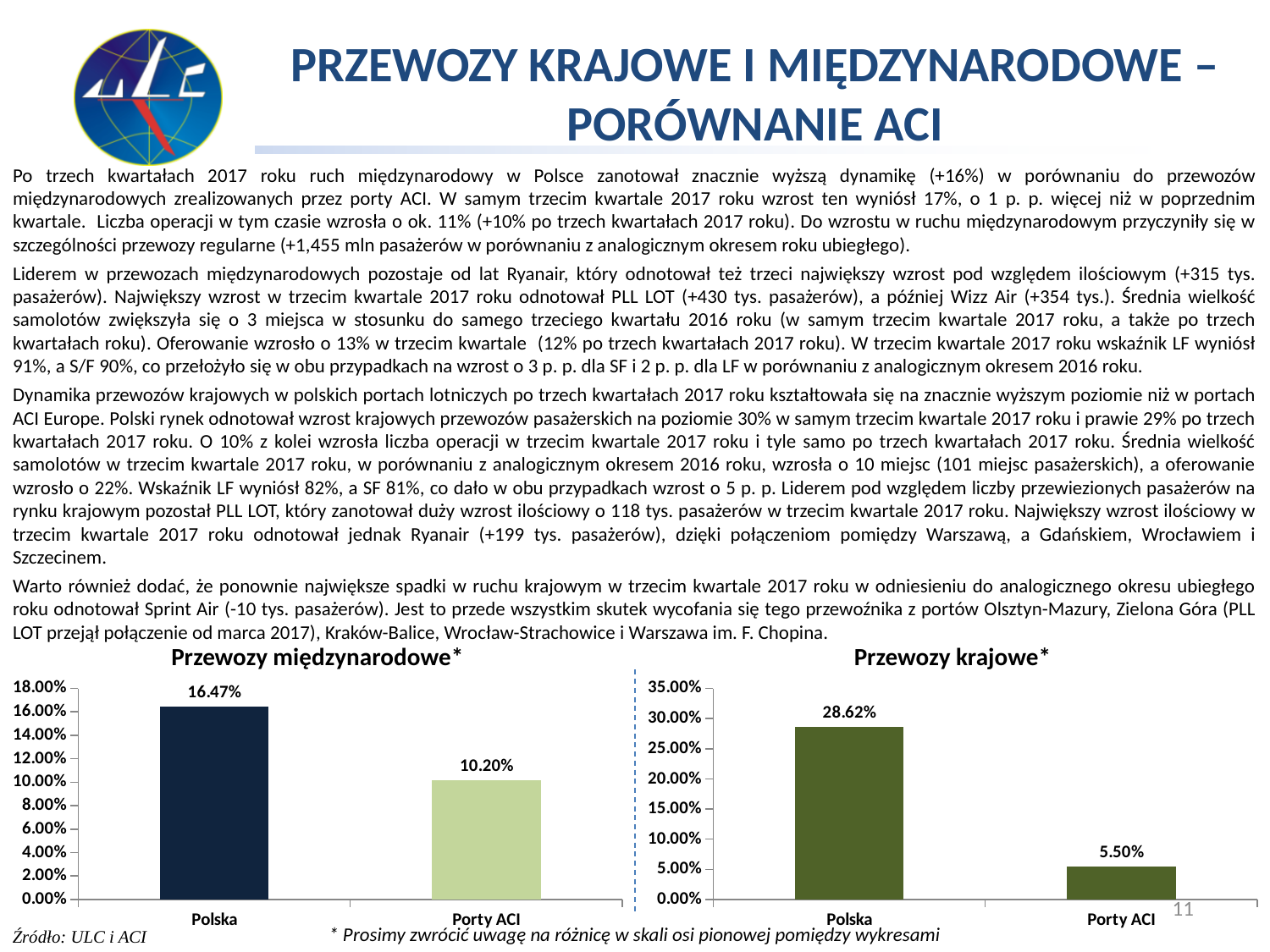
What is the highest tick value on the vertical axis of the 'Przewozy krajowe*' chart? 35.00% What type of chart is the 'Przewozy krajowe*' chart? bar chart In the 'Przewozy krajowe*' chart, which category has the lowest value? Porty ACI In the 'Przewozy krajowe*' chart, what is the value for Porty ACI? 5.50% In the 'Przewozy międzynarodowe*' chart, which category has the higher value? Polska In the 'Przewozy międzynarodowe*' chart, what is the difference between the values for Polska and Porty ACI? 6.27% In the 'Przewozy międzynarodowe*' chart, what is the value for Porty ACI? 10.20% In the 'Przewozy krajowe*' chart, what is the value for Polska? 28.62% In the 'Przewozy krajowe*' chart, is the value for Polska greater or less than 25.00%? greater In the 'Przewozy krajowe*' chart, what is the difference between the values for Polska and Porty ACI? 23.12% In the 'Przewozy międzynarodowe*' chart, what is the value for Polska? 16.47% How many categories are shown in the 'Przewozy międzynarodowe*' chart? 2